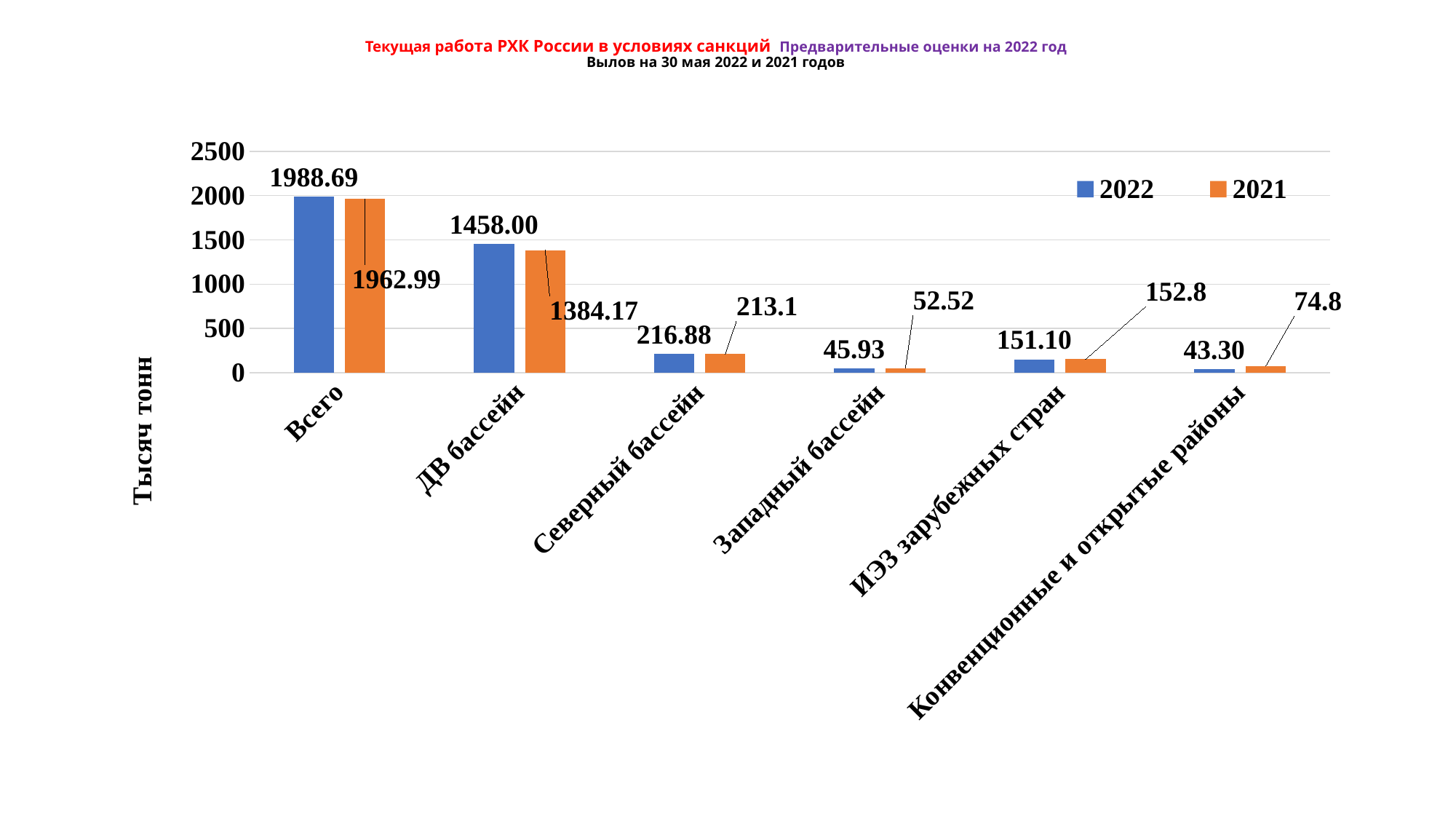
How many series does the legend list? 2 What is the 2022 value for Всего? 1988.69 Which is larger for Конвенционные и открытые районы: the 2022 value or the 2021 value? 2021 Which category has the lowest 2022 value? Конвенционные и открытые районы What is the difference between the 2022 and 2021 values for Всего? 25.70 Which category has the highest 2021 value? Всего What is the 2021 value for Конвенционные и открытые районы? 74.8 What is the 2021 value for ДВ бассейн? 1384.17 What is the 2022 value for Западный бассейн? 45.93 Is the 2022 value for ДВ бассейн greater or less than 1000? greater How many categories are shown on the x axis? 6 What is the label of the vertical axis? Тысяч тонн